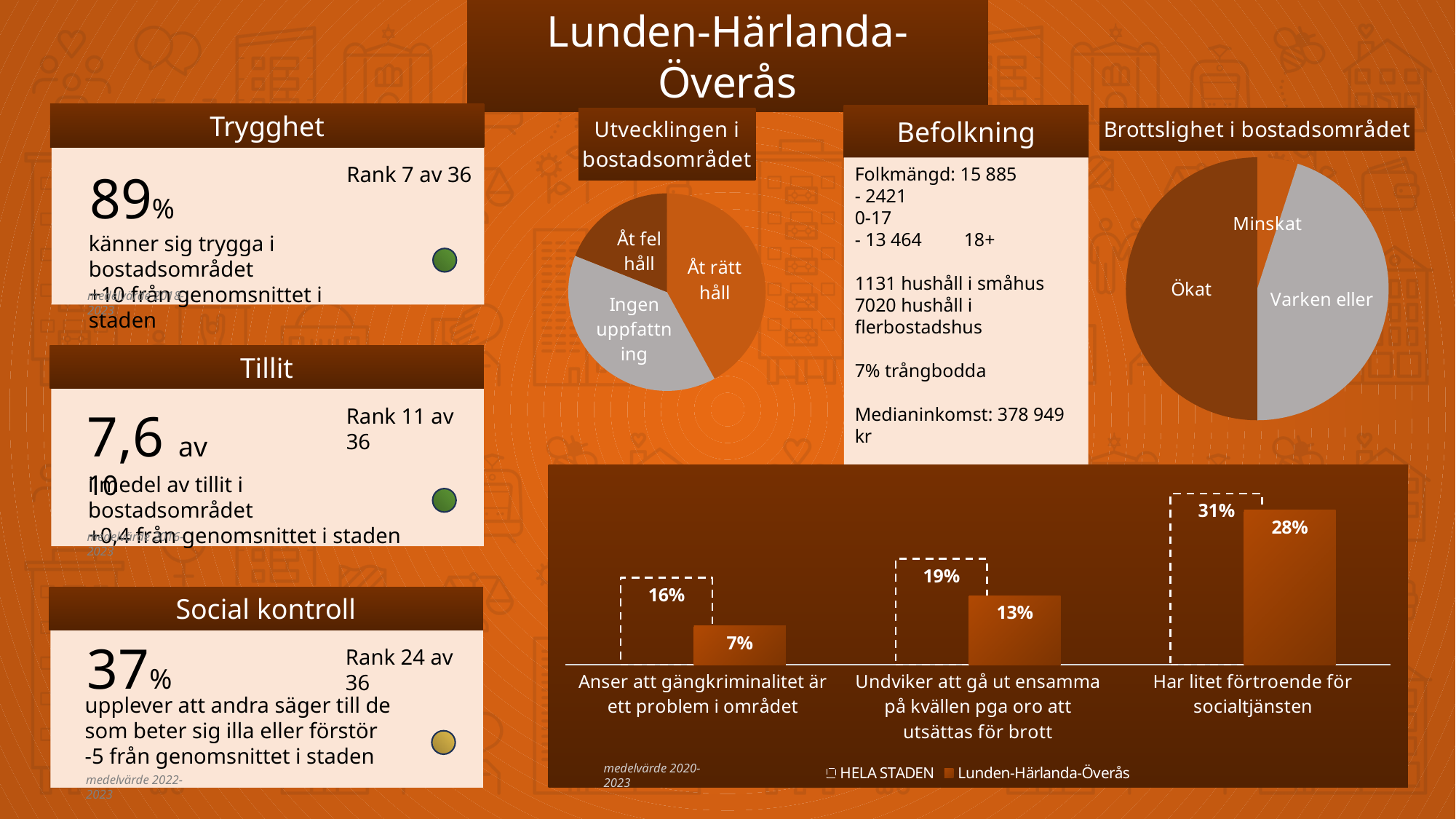
How many series does the legend of the bottom bar chart list? 2 What kind of chart is the chart titled 'Brottslighet i bostadsområdet'? Pie chart How many categories are shown in the bottom bar chart? 3 In the bottom bar chart, which is larger for 'Har litet förtroende för socialtjänsten': HELA STADEN or Lunden-Härlanda-Överås? HELA STADEN In the bottom bar chart, which category has the lowest value for Lunden-Härlanda-Överås? Anser att gängkriminalitet är ett problem i området In the pie chart titled 'Utvecklingen i bostadsområdet', which slice is the smallest? Åt fel håll In the bottom bar chart, which category has the highest value for HELA STADEN? Har litet förtroende för socialtjänsten In the bottom bar chart, what is the value for Lunden-Härlanda-Överås for 'Har litet förtroende för socialtjänsten'? 28% In the pie chart titled 'Brottslighet i bostadsområdet', which slice is the smallest? Minskat In the bottom bar chart, what is the value for Lunden-Härlanda-Överås for 'Anser att gängkriminalitet är ett problem i området'? 7% In the bottom bar chart, what is the value for HELA STADEN for 'Undviker att gå ut ensamma på kvällen pga oro att utsättas för brott'? 19% In the bottom bar chart, what is the difference between HELA STADEN and Lunden-Härlanda-Överås for 'Anser att gängkriminalitet är ett problem i området'? 9%